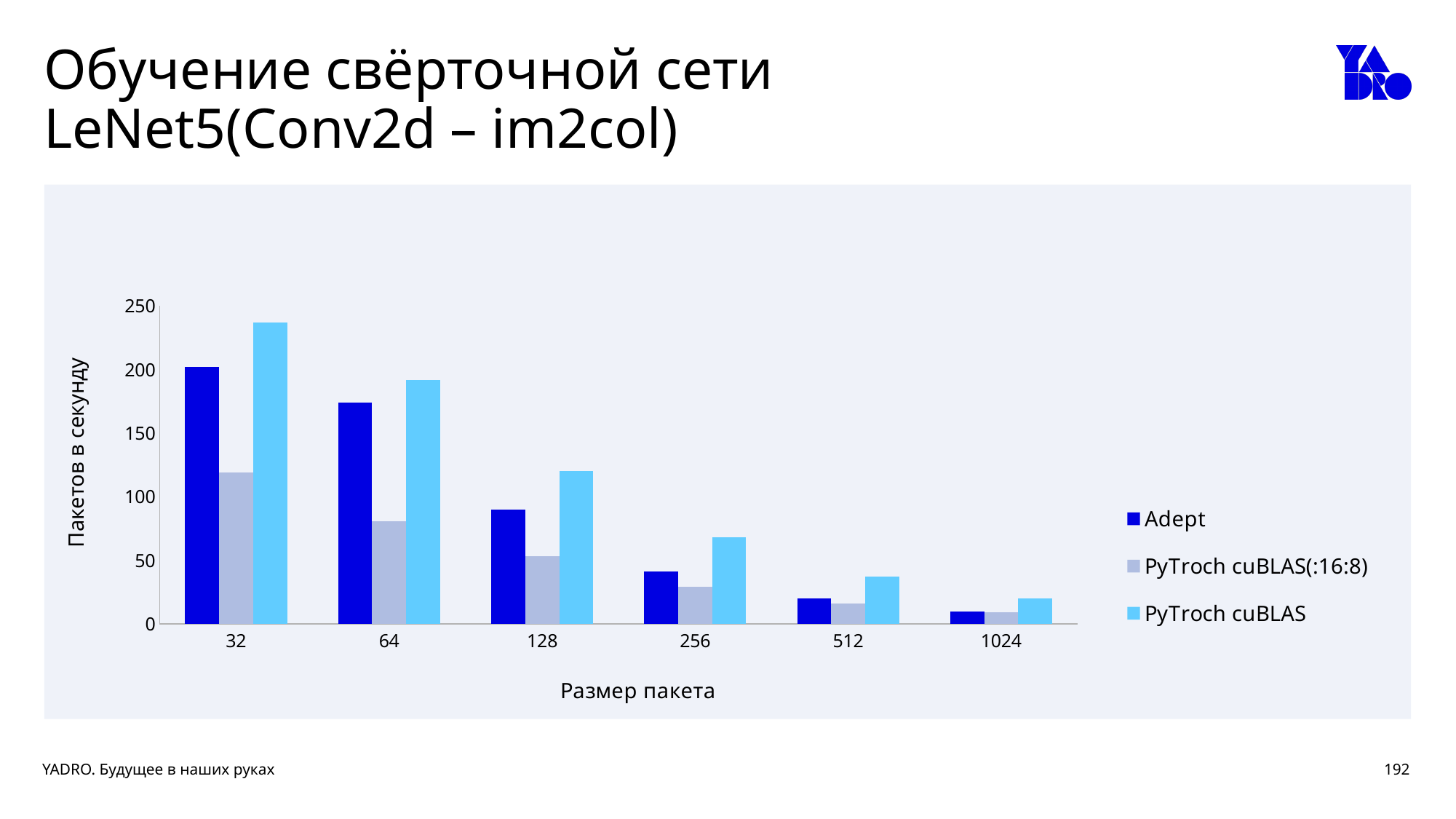
How many batch sizes (Размер пакета) are shown on the x axis? 6 Is the Adept value for batch size 32 greater or less than 150? greater How many series does the legend list? 3 At batch size 256, which is larger: Adept or PyTroch cuBLAS(:16:8)? Adept Is the PyTroch cuBLAS value for batch size 64 greater or less than 150? greater Is the PyTroch cuBLAS(:16:8) value for batch size 128 greater or less than 100? less Do the Adept values rise or fall as the batch size increases along the x axis? fall At batch size 32, which is larger: Adept or PyTroch cuBLAS? PyTroch cuBLAS For which batch size is the Adept value lowest? 1024 What is the label of the y axis? Пакетов в секунду For which batch size is the PyTroch cuBLAS value highest? 32 What kind of chart is shown on the slide? bar chart